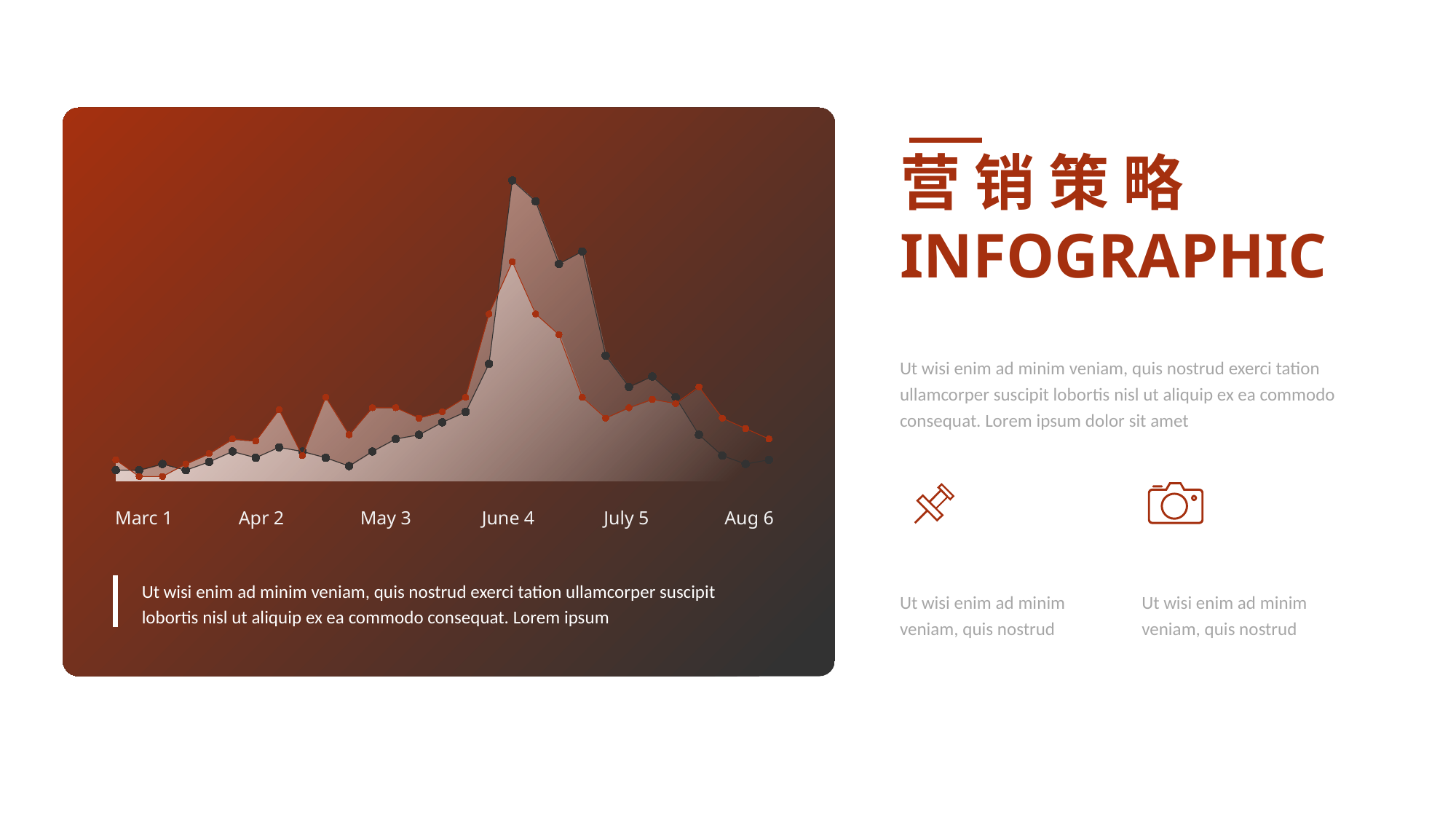
What is the last label on the x axis of the chart? Aug 6 How many lines (series) are plotted on the chart? 2 How many labels are shown along the x axis of the chart? 6 What is the first label on the x axis of the chart? Marc 1 Which x-axis label comes between Apr 2 and June 4? May 3 What kind of chart is shown on the slide? area chart At the peak near June 4, which line is higher: the dark line or the red line? the dark line At Aug 6, which line is higher: the dark line or the red line? the red line Do the values on the chart rise or fall between Marc 1 and June 4? rise Near which x-axis label does the chart reach its highest peak? June 4 Do the values on the chart rise or fall between June 4 and Aug 6? fall